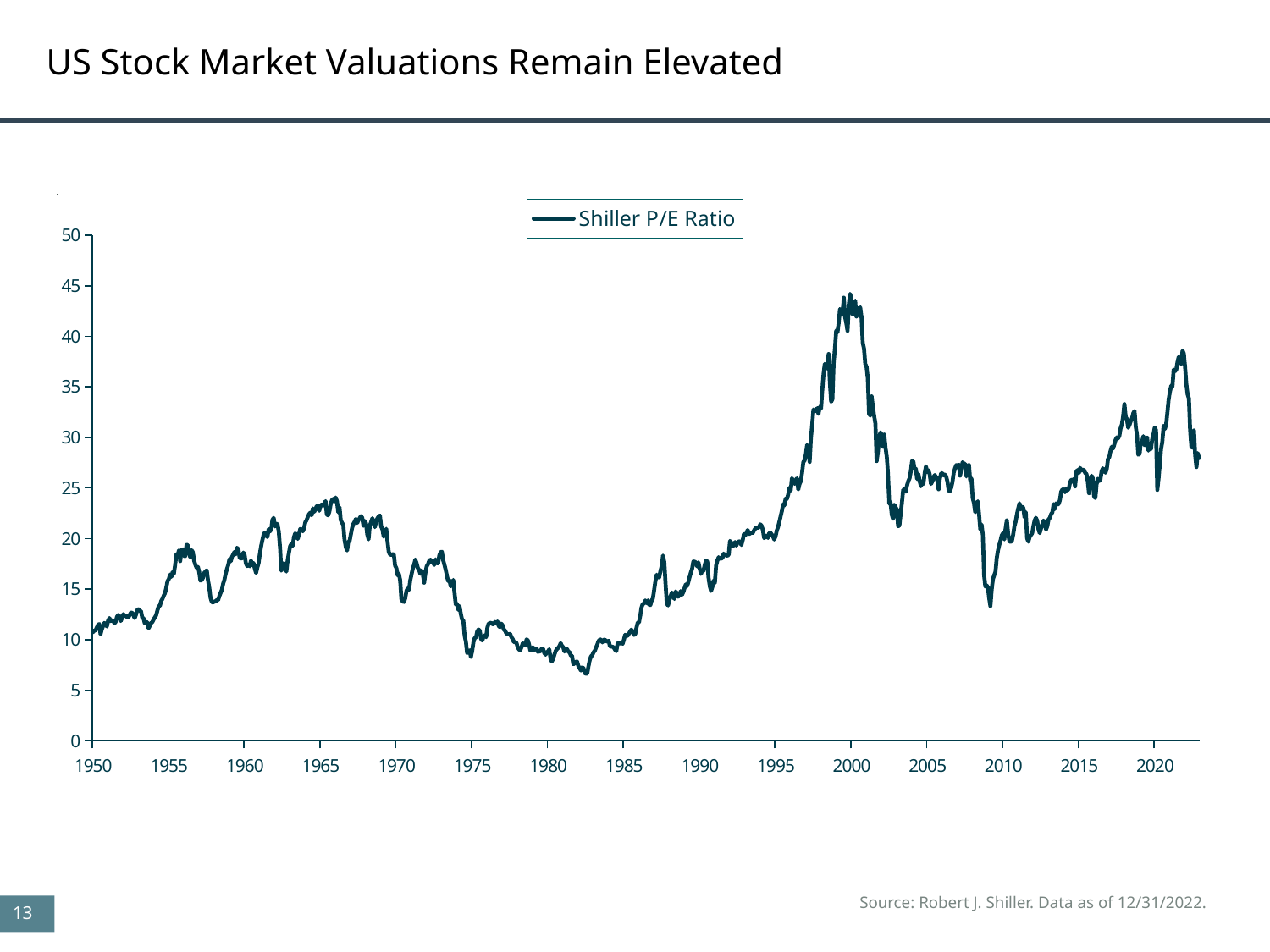
What is the title of the slide containing the chart? US Stock Market Valuations Remain Elevated How many series does the legend list? 1 Does the Shiller P/E Ratio generally rise or fall between 1982 and 2000? rise Around which year labelled on the x axis does the Shiller P/E Ratio reach its highest point? 2000 Is the Shiller P/E Ratio at the end of the series (late 2022) greater or less than 30? less What kind of chart is shown on the slide? line chart Is the Shiller P/E Ratio in the early 1980s greater or less than 10? less What series name is shown in the legend? Shiller P/E Ratio Is the Shiller P/E Ratio around 2000 higher or lower than around 2020? higher Is the Shiller P/E Ratio around 1965 greater or less than 20? greater